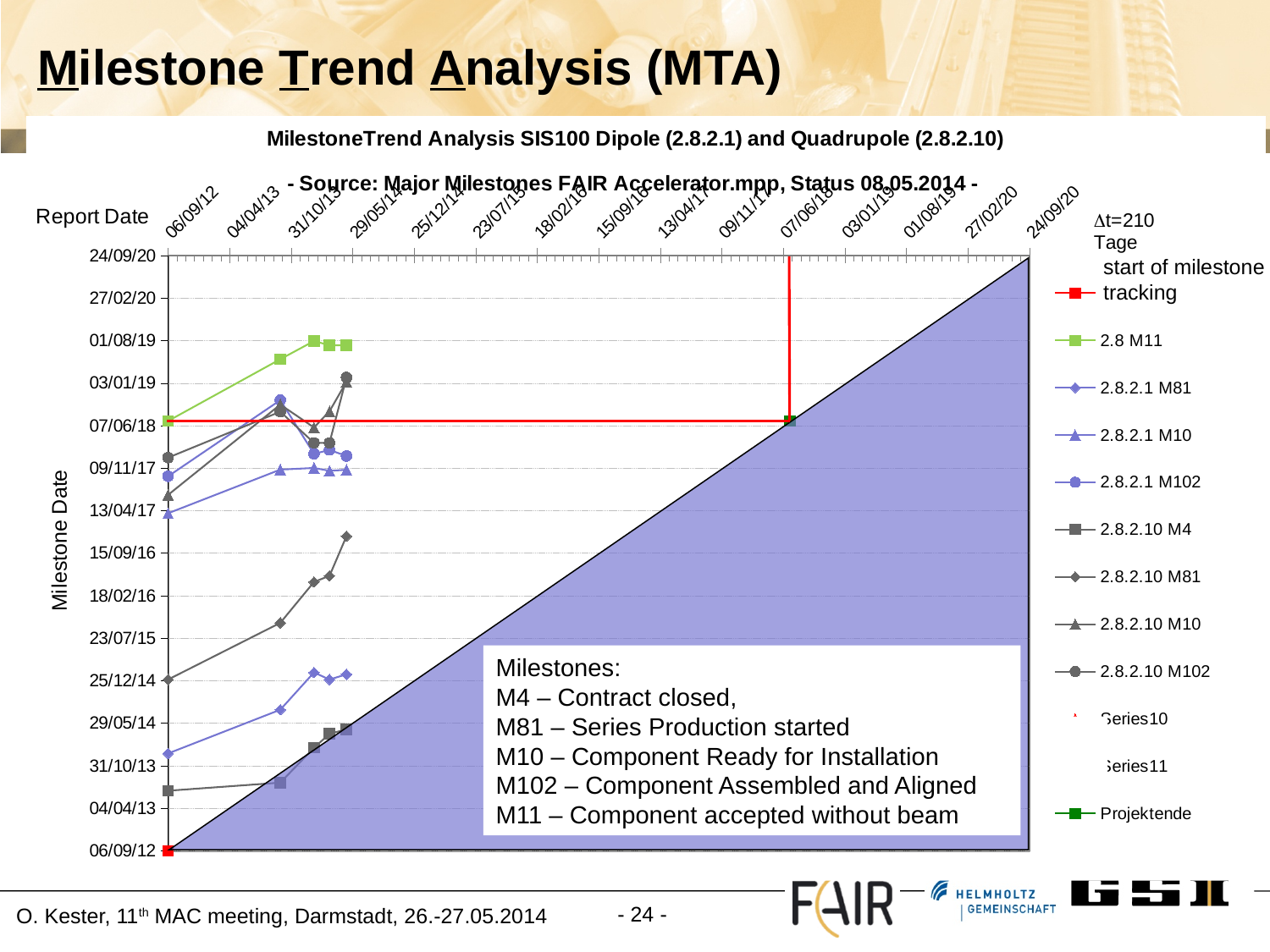
Which series has the latest (highest) milestone dates on the chart? 2.8 M11 Do the milestone dates for 2.8.2.10 M81 rise or fall as the report date advances? rise Is the latest milestone date for 2.8 M11 later or earlier than 03/01/19? later What is the label of the vertical axis? Milestone Date How many entries does the chart legend list? 12 Do the milestone dates for 2.8 M11 rise or fall as the report date advances? rise Which milestone series has the earliest (lowest) milestone dates on the chart? 2.8.2.10 M4 At which date is the start of milestone tracking marker placed? 06/09/12 Which series has later milestone dates, 2.8.2.1 M81 or 2.8.2.1 M10? 2.8.2.1 M10 What is the title of the chart? MilestoneTrend Analysis SIS100 Dipole (2.8.2.1) and Quadrupole (2.8.2.10) - Source: Major Milestones FAIR Accelerator.mpp, Status 08.05.2014 - What kind of chart is shown on the slide? line chart